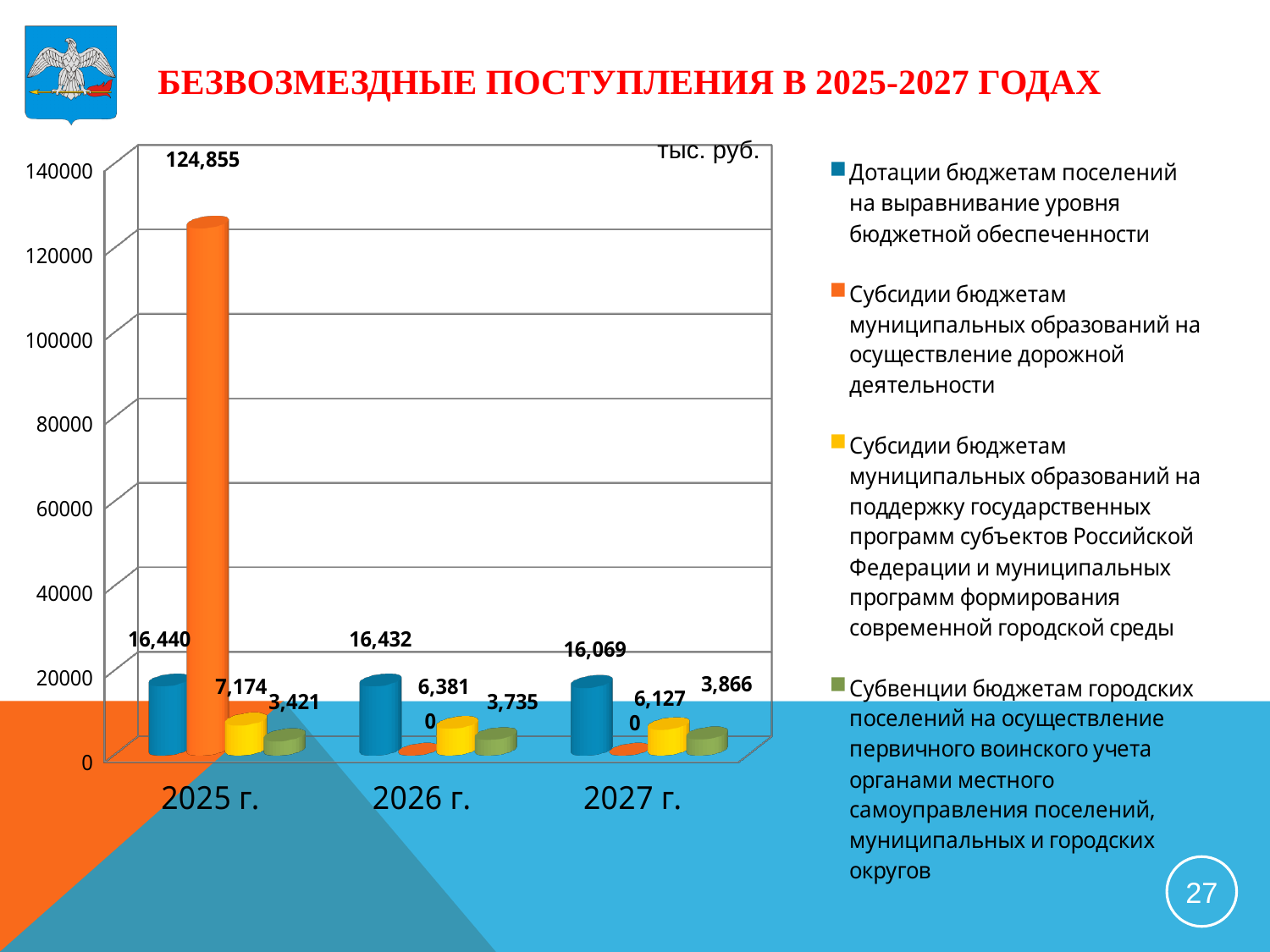
What is the difference between the 'Субсидии ... формирования современной городской среды' values for 2025 г. and 2027 г.? 1,047 How many years are shown on the x axis of the chart? 3 In which year is the 'Дотации бюджетам поселений на выравнивание уровня бюджетной обеспеченности' series lowest? 2027 г. Is the value of the 'Субсидии ... на осуществление дорожной деятельности' series for 2025 г. greater or less than 120000? greater Which is larger: the 'Субвенции ...' value for 2027 г. or for 2025 г.? 2027 г. How many series does the chart legend list? 4 What is the value of the 'Субсидии бюджетам муниципальных образований на осуществление дорожной деятельности' series for 2026 г.? 0 What is the value of the 'Субсидии бюджетам муниципальных образований на осуществление дорожной деятельности' series for 2025 г.? 124,855 In which year is the 'Субсидии ... на поддержку государственных программ ... формирования современной городской среды' series highest? 2025 г. What is the value of the 'Субвенции бюджетам городских поселений на осуществление первичного воинского учета...' series for 2026 г.? 3,735 What is the value of the 'Дотации бюджетам поселений на выравнивание уровня бюджетной обеспеченности' series for 2027 г.? 16,069 What type of chart is shown on the slide? Bar chart